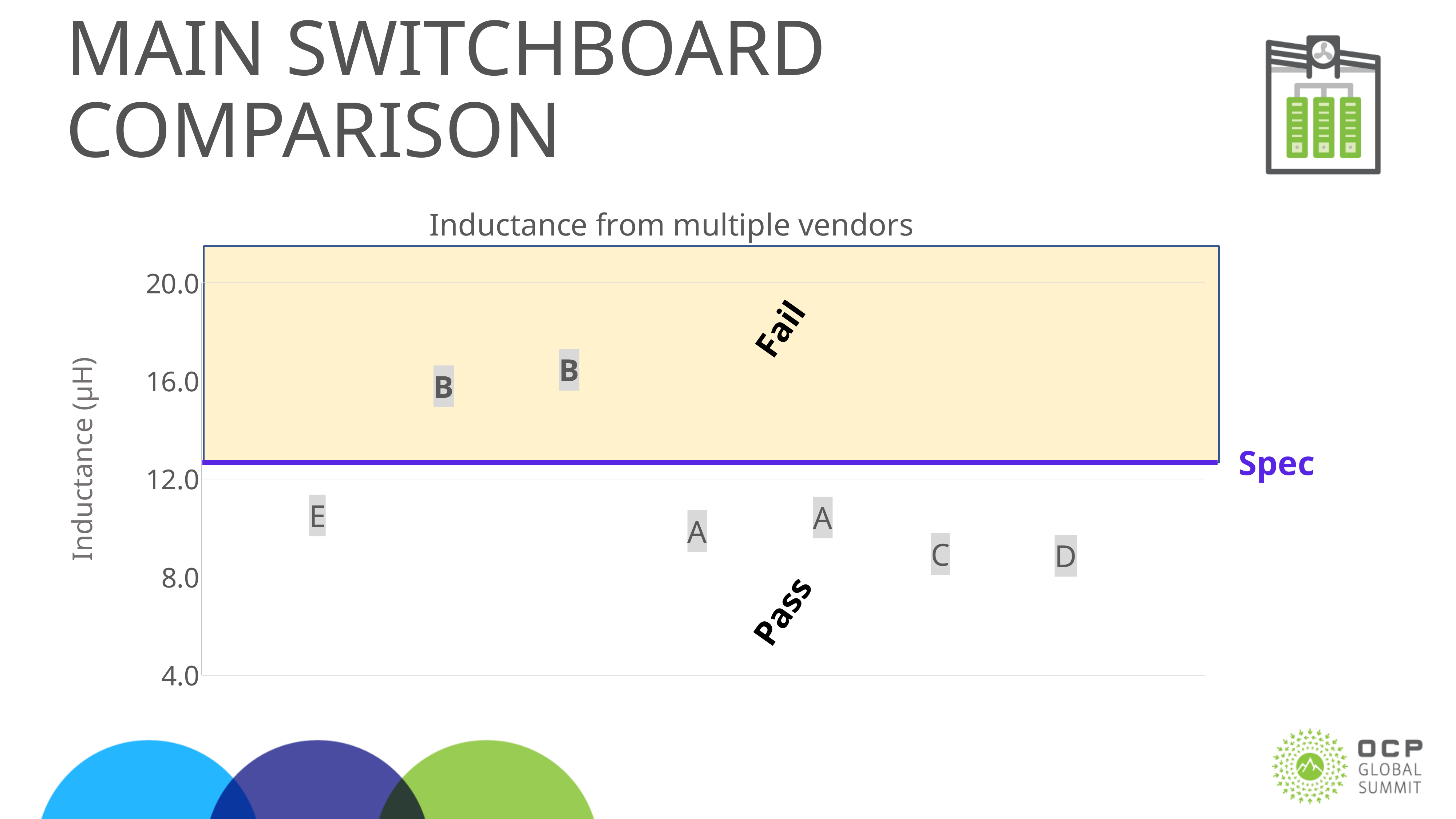
How many data points are plotted on the chart? 7 Which vendor's points lie in the Fail region above the Spec line? B Which has the higher inductance, vendor E or vendor C? E What kind of chart is shown on the slide? scatter chart Is the value for vendor E greater or less than 12.0 μH? less What does the purple horizontal line on the chart represent? Spec Which has the higher inductance, vendor B or vendor A? B Is the value for vendor D greater or less than 12.0 μH? less Is the value for vendor C greater or less than 8.0 μH? greater How many distinct vendor labels (letters) appear on the chart? 5 What is the title of the chart? Inductance from multiple vendors